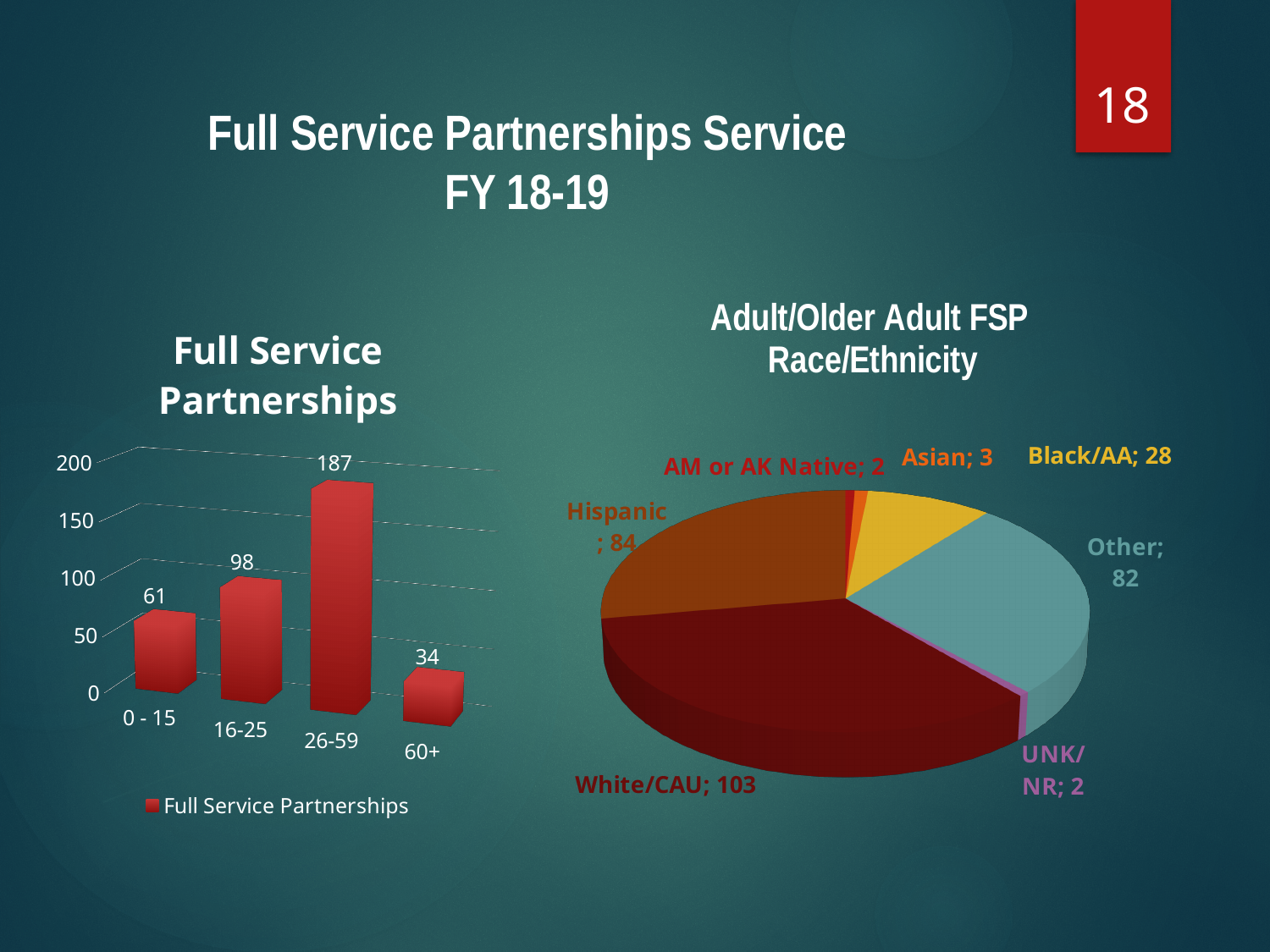
In the Adult/Older Adult FSP Race/Ethnicity pie chart, which category has the largest value? White/CAU In the Full Service Partnerships bar chart, what is the value for the 26-59 age group? 187 In the Adult/Older Adult FSP Race/Ethnicity pie chart, what is the value for Black/AA? 28 In the Full Service Partnerships bar chart, how many age groups are shown? 4 In the Full Service Partnerships bar chart, what is the value for the 0 - 15 age group? 61 What type of chart is the Full Service Partnerships chart on the left? Bar chart In the Adult/Older Adult FSP Race/Ethnicity pie chart, which is larger, Other or Hispanic? Hispanic In the Full Service Partnerships bar chart, what is the difference between the 16-25 and 60+ values? 64 In the Full Service Partnerships bar chart, which age group has the lowest value? 60+ In the Adult/Older Adult FSP Race/Ethnicity pie chart, what is the value for Hispanic? 84 In the Adult/Older Adult FSP Race/Ethnicity pie chart, how many categories are shown? 7 In the Full Service Partnerships bar chart, which age group has the highest value? 26-59